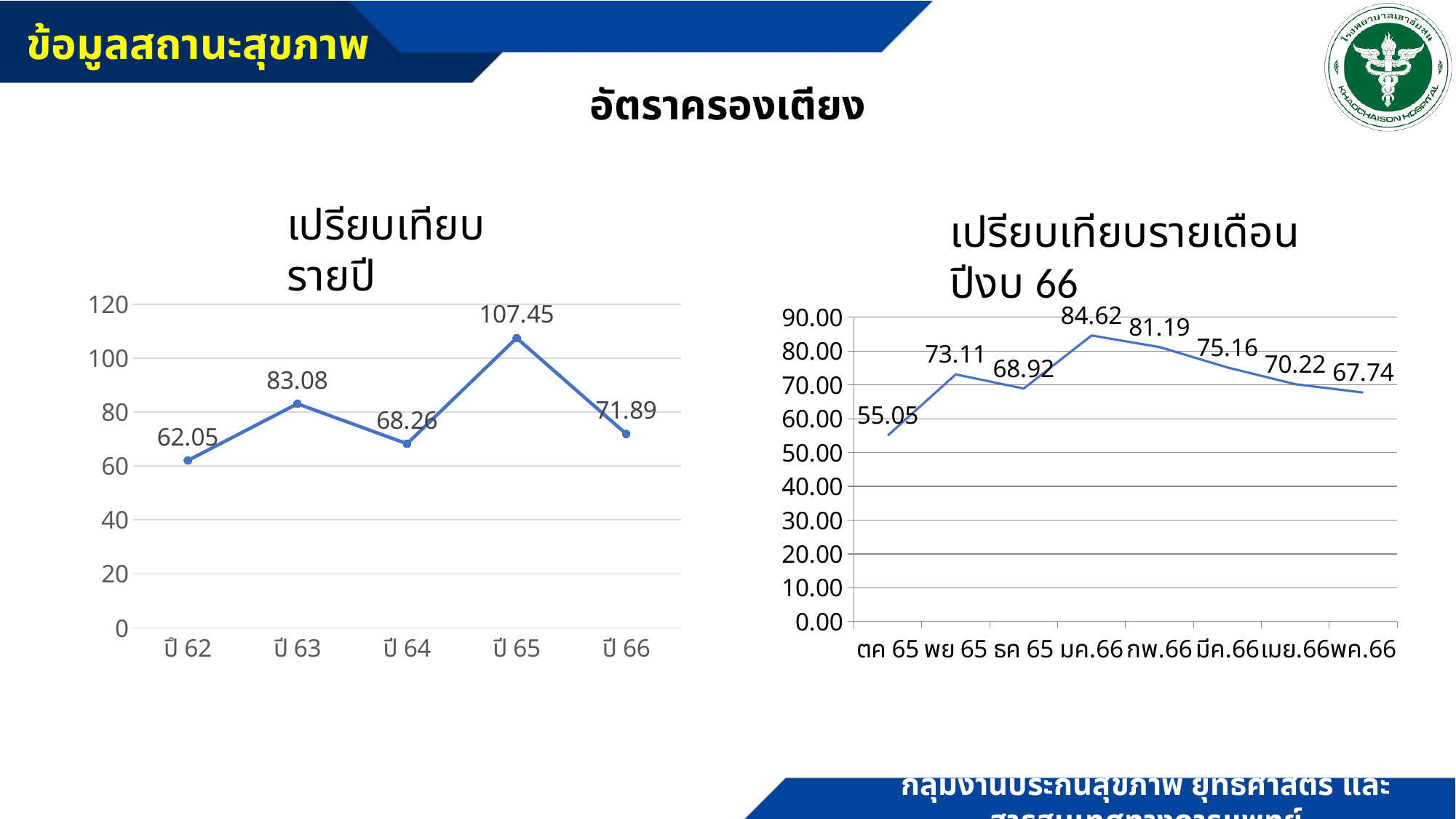
In the left chart (เปรียบเทียบรายปี), what is the difference between the values for ปี 65 and ปี 66? 35.56 In the right chart (เปรียบเทียบรายเดือน ปีงบ 66), which month has the lowest value? ตค 65 In the left chart (เปรียบเทียบรายปี), which year has the lowest value? ปี 62 In the left chart (เปรียบเทียบรายปี), what is the value for ปี 65? 107.45 In the left chart (เปรียบเทียบรายปี), how many years are plotted? 5 What kind of chart is the left chart (เปรียบเทียบรายปี)? line chart In the right chart (เปรียบเทียบรายเดือน ปีงบ 66), do the values rise or fall from มค.66 to พค.66? fall In the right chart (เปรียบเทียบรายเดือน ปีงบ 66), what is the value for มค.66? 84.62 In the right chart (เปรียบเทียบรายเดือน ปีงบ 66), how many months are plotted? 8 In the left chart (เปรียบเทียบรายปี), what is the value for ปี 62? 62.05 In the right chart (เปรียบเทียบรายเดือน ปีงบ 66), which month has the highest value? มค.66 In the right chart (เปรียบเทียบรายเดือน ปีงบ 66), which is larger, the value for พย 65 or ธค 65? พย 65